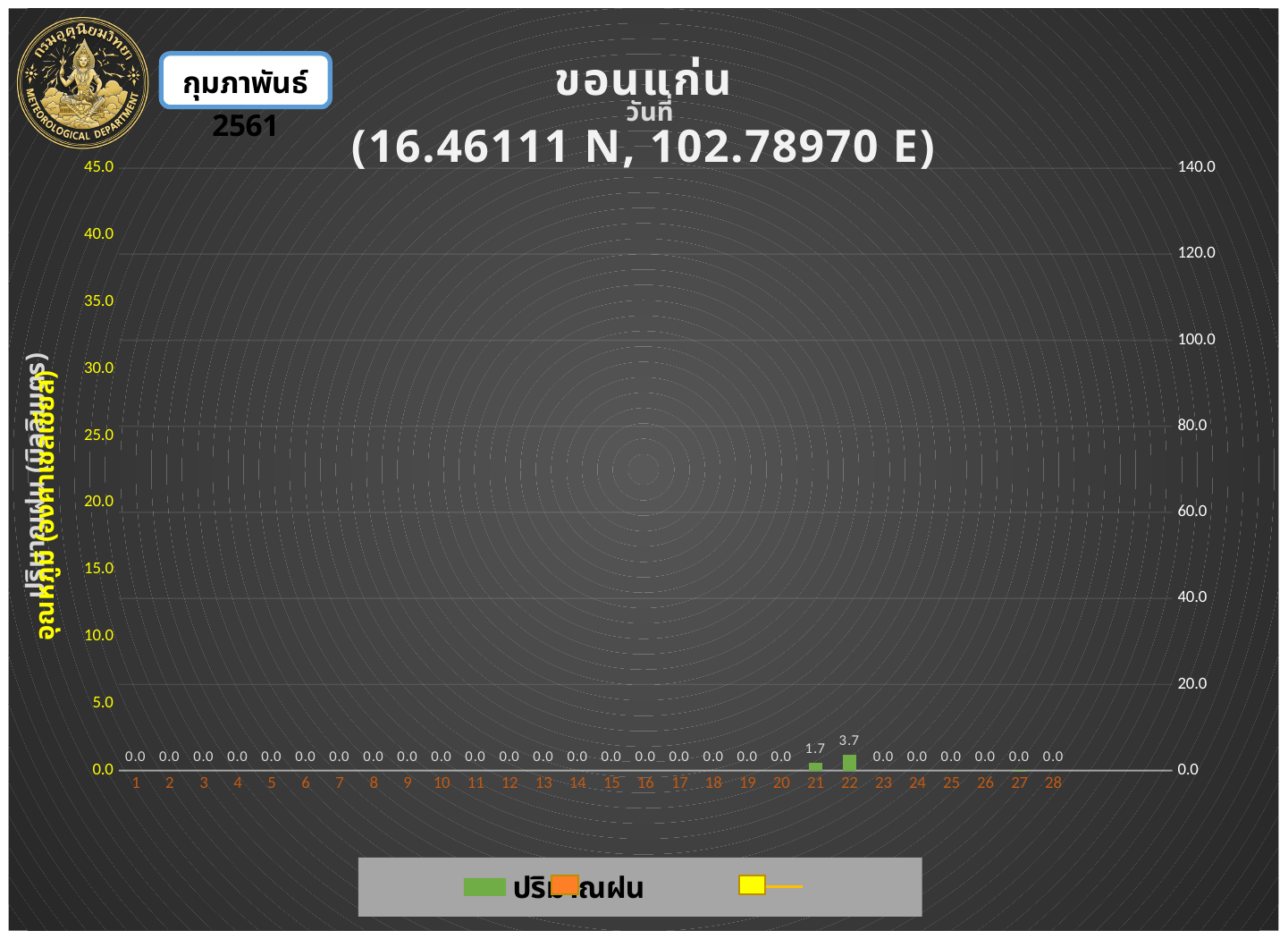
What is the highest value shown on the left vertical axis? 45.0 How many days are shown on the x axis? 28 What is the rainfall value shown for day 21? 1.7 What kind of chart is used to show the rainfall values? bar chart What is the highest value shown on the right vertical axis? 140.0 What is the rainfall value shown for day 5? 0.0 What is the difference between the rainfall values for day 22 and day 21? 2.0 Which has a larger rainfall value, day 21 or day 22? day 22 What is the rainfall value shown for day 22? 3.7 Which day has the highest rainfall value? 22 Is the rainfall value for day 22 greater or less than 5.0? less